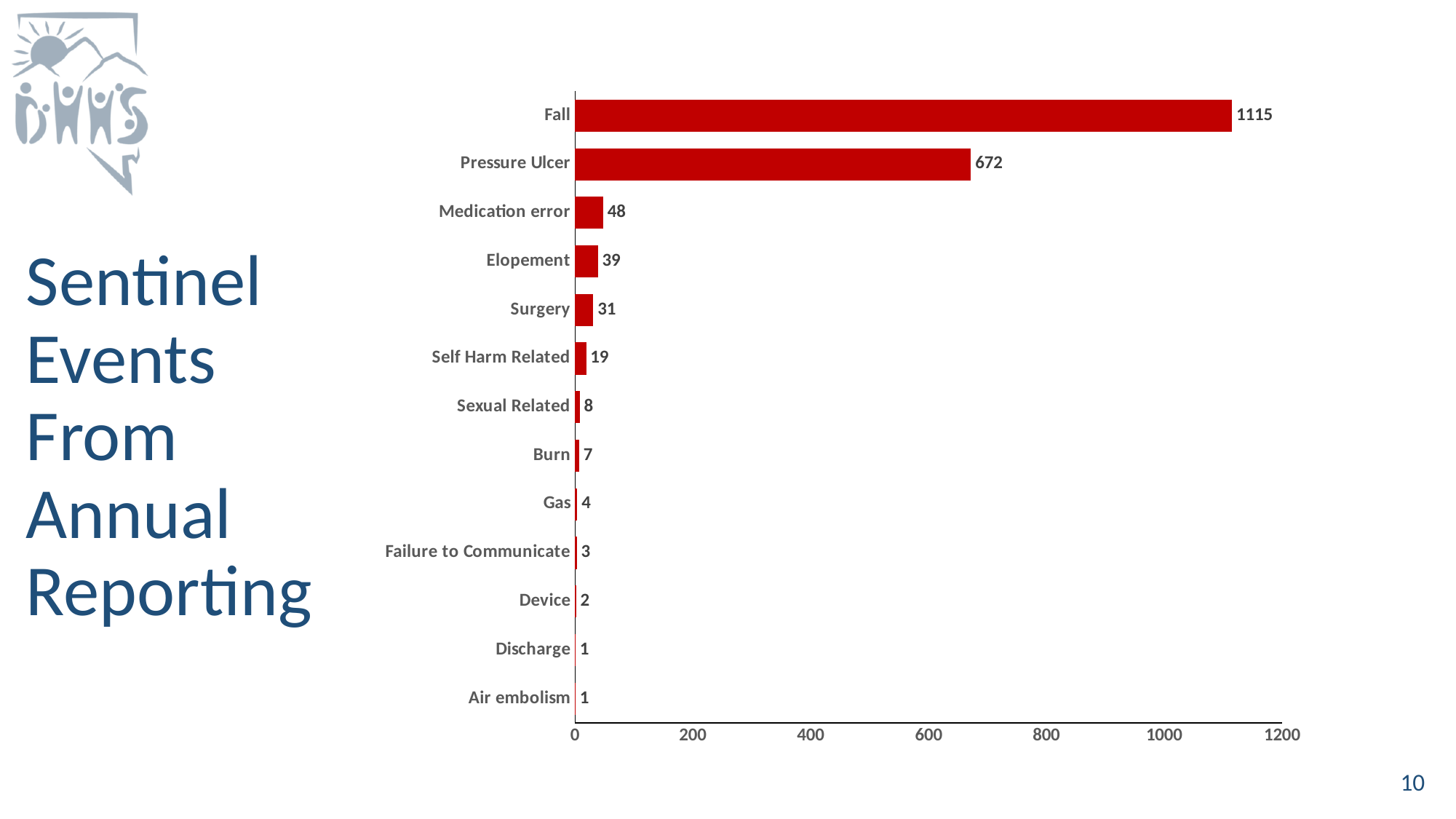
What is the value for Self Harm Related? 19 What kind of chart is shown on the slide? bar chart What colour are the bars in the chart? red What is the value for Fall? 1115 Which is larger, the value for Surgery or the value for Elopement? Elopement What is the value for Pressure Ulcer? 672 What is the difference between the values for Medication error and Elopement? 9 Is the value for Pressure Ulcer greater or less than 600? greater What is the value for Medication error? 48 How many categories are shown in the chart? 13 Which category has the highest value? Fall What is the difference between the values for Fall and Pressure Ulcer? 443